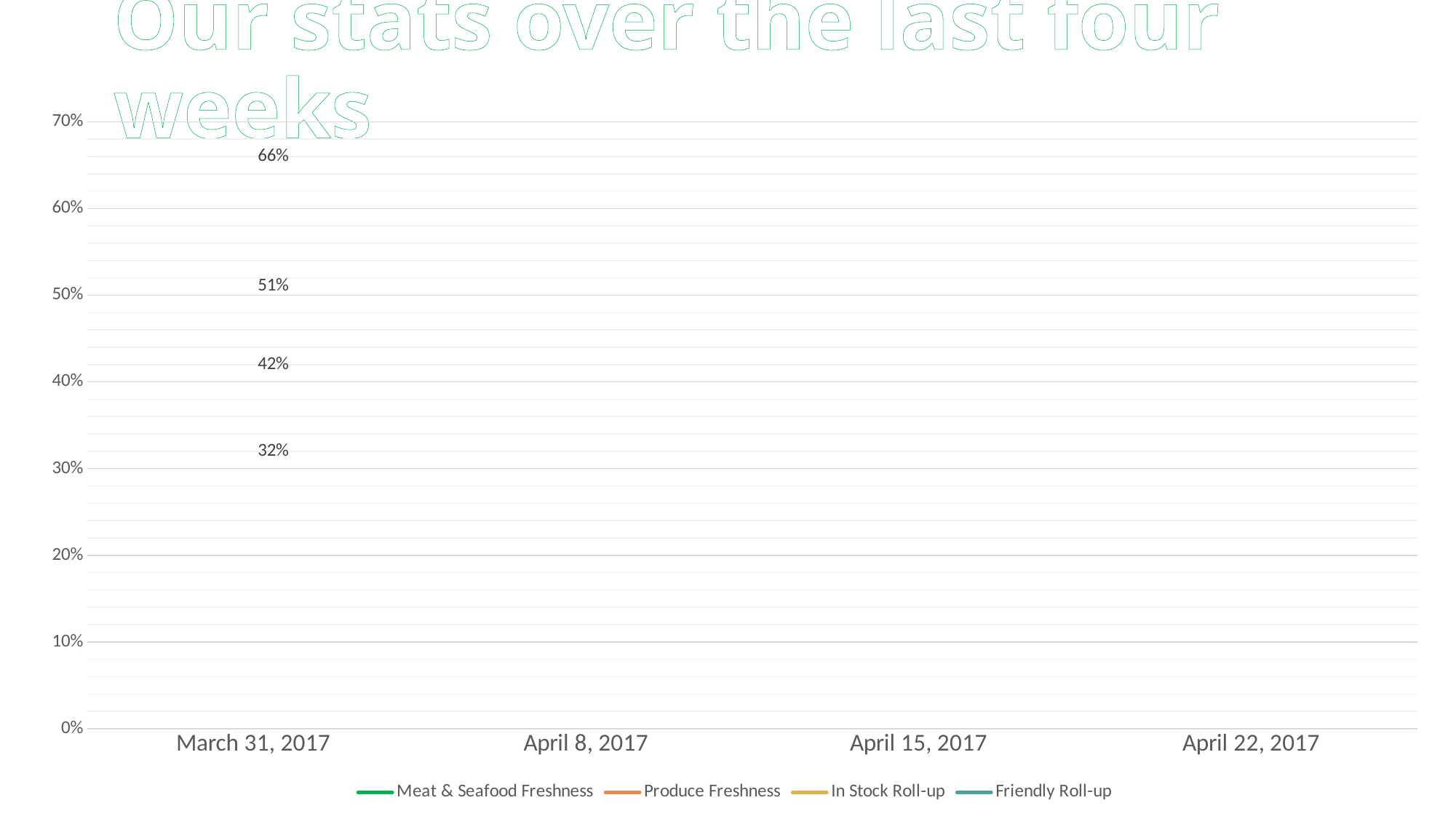
What is the lowest data label shown for March 31, 2017? 32% How many series does the legend list? 4 What is the highest data label shown for March 31, 2017? 66% What is the last date shown on the x axis? April 22, 2017 What is the first date shown on the x axis? March 31, 2017 What kind of chart is shown on the slide? Line chart What is the title of the chart on the slide? Our stats over the last four weeks What is the maximum value shown on the y axis? 70% How many data labels are printed for March 31, 2017? 4 How many dates are shown on the x axis? 4 Which series is listed first in the legend? Meat & Seafood Freshness What is the difference between the highest and lowest data labels shown for March 31, 2017? 34%